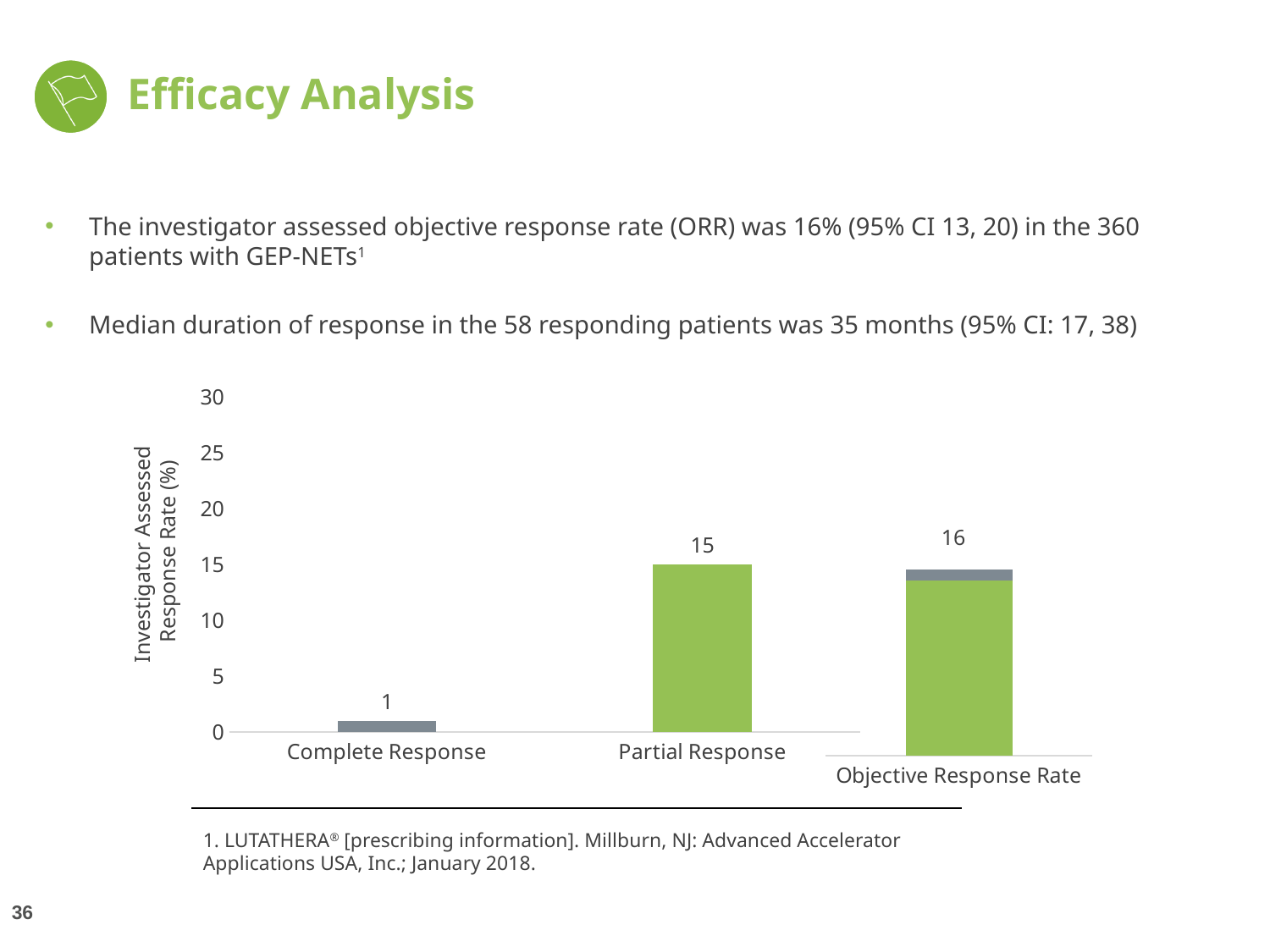
What kind of chart is shown on the slide? bar chart Which category has the highest value? Objective Response Rate What is the label of the vertical axis? Investigator Assessed Response Rate (%) How many categories are shown on the x axis? 3 Is the value for Partial Response greater or less than 10? greater What is the value for Complete Response? 1 What is the difference between the Partial Response value and the Complete Response value? 14 Is the value for Complete Response greater or less than 5? less What is the value for Objective Response Rate? 16 Which category has the lowest value? Complete Response What is the value for Partial Response? 15 Which is larger, the value for Partial Response or the value for Complete Response? Partial Response